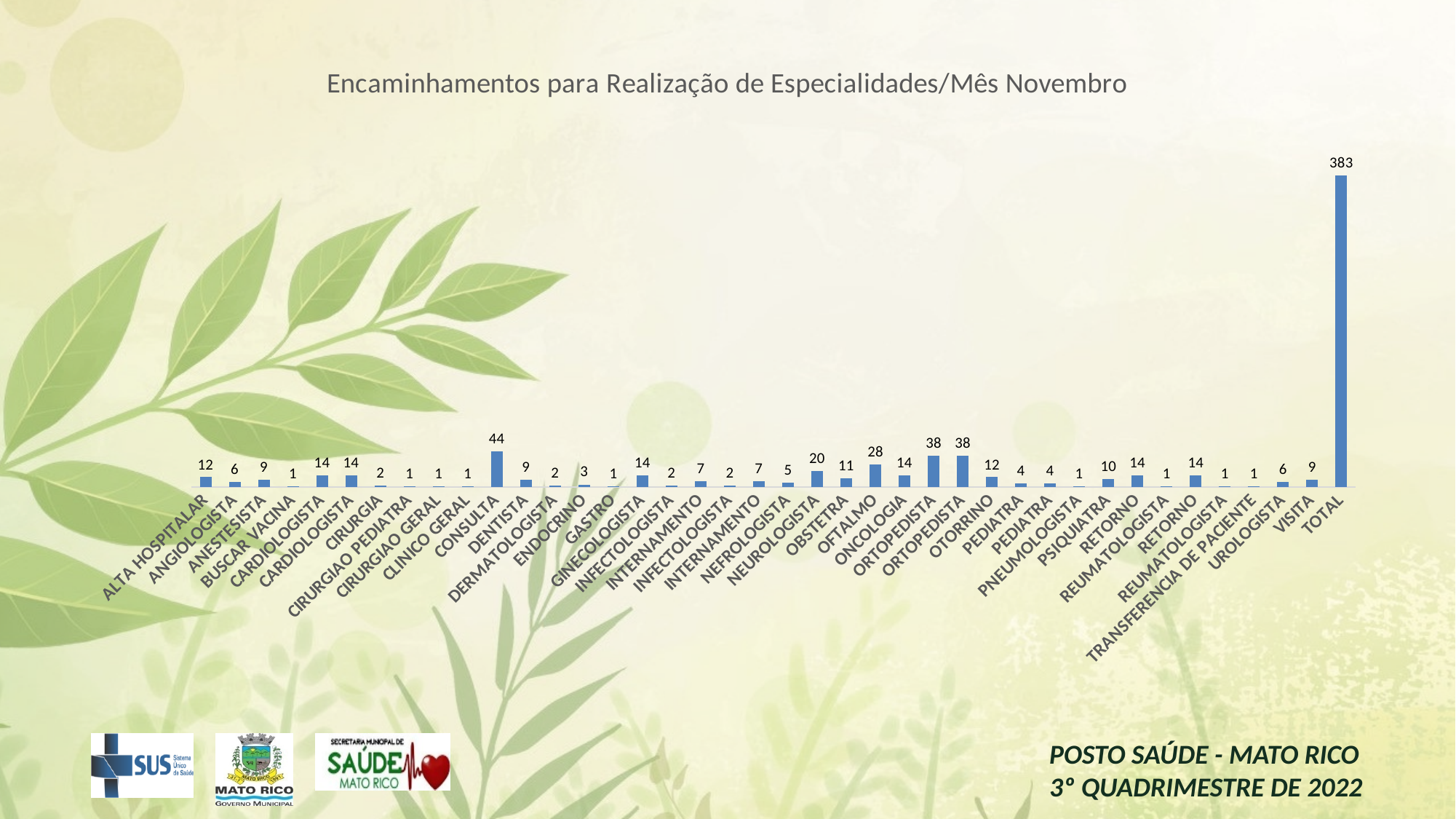
What is the value for NEFROLOGISTA? 5 What is the value for NEUROLOGISTA? 20 Which is larger, the value for NEUROLOGISTA or the value for OBSTETRA? NEUROLOGISTA What is the value for CONSULTA? 44 What is the value for the TOTAL bar? 383 What is the value for OFTALMO? 28 What is the title of the chart? Encaminhamentos para Realização de Especialidades/Mês Novembro What is the difference between the values for OTORRINO and UROLOGISTA? 6 Excluding the TOTAL bar, which specialty has the highest value? CONSULTA What is the value for PSIQUIATRA? 10 What is the difference between the values for CONSULTA and OFTALMO? 16 What kind of chart is shown on the slide? Bar chart